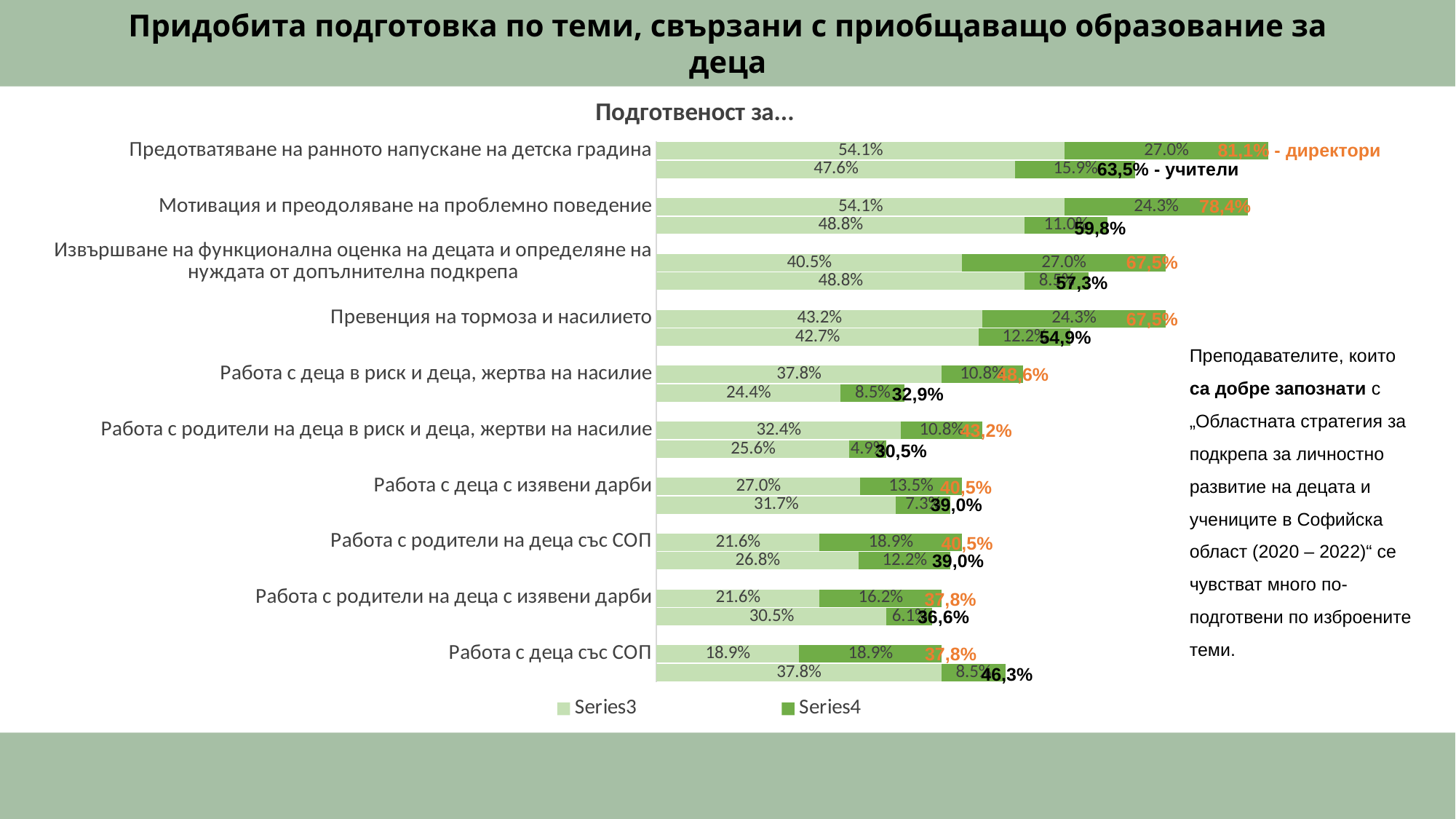
What kind of chart is shown on the slide? Stacked bar chart For 'Работа с деца със СОП', is the Series4 value larger on the directors bar or on the teachers bar? Directors bar How many topic categories are listed on the vertical axis of the chart? 10 What is the Series4 value on the teachers (учители) bar for 'Превенция на тормоза и насилието'? 12.2% What are the two legend entries of the chart? Series3 and Series4 Which category has the highest total for directors (директори)? Предотватяване на ранното напускане на детска градина How many series does the chart legend list? 2 What is the total shown for the directors (директори) bar for 'Предотватяване на ранното напускане на детска градина'? 81,1% What is the Series3 value on the directors (директори) bar for 'Предотватяване на ранното напускане на детска градина'? 54.1% What is the difference between the directors total (81,1%) and the teachers total (63,5%) for 'Предотватяване на ранното напускане на детска градина'? 17.6 percentage points What is the total shown for the teachers (учители) bar for 'Работа с деца със СОП'? 46,3% Which category has the lowest total for teachers (учители)? Работа с родители на деца в риск и деца, жертви на насилие